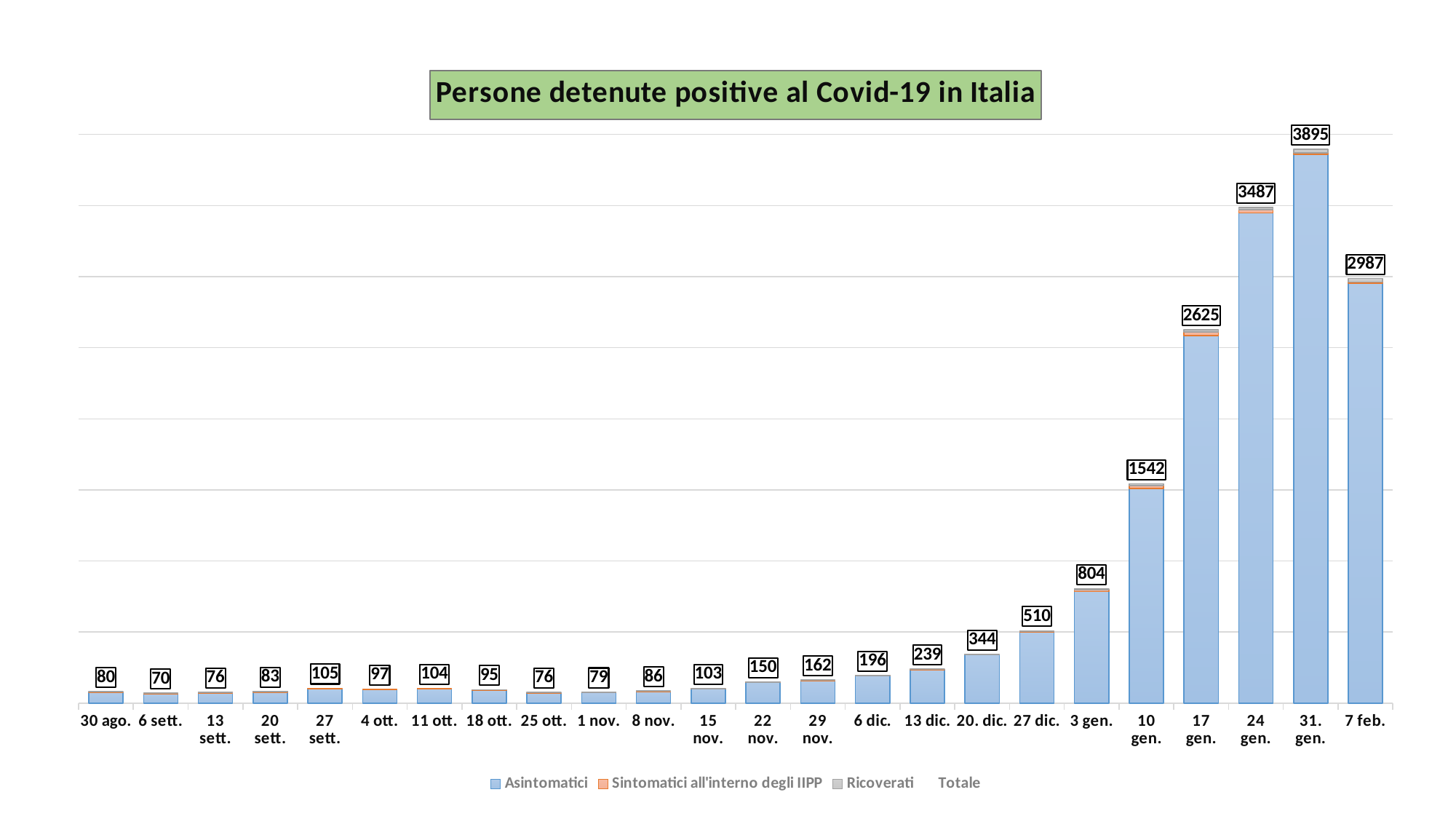
How many dates are shown on the x axis? 24 Which date has the highest total? 31. gen. Which has a larger total, 17 gen. or 7 feb.? 7 feb. What is the total value shown for 31. gen.? 3895 What is the total value shown for 30 ago.? 80 How many entries does the legend list? 4 What kind of chart is shown? Stacked bar chart Which date has the lowest total? 6 sett. What is the difference between the totals for 10 gen. and 3 gen.? 738 What is the total value shown for 7 feb.? 2987 What is the difference between the totals for 31. gen. and 24 gen.? 408 What is the title of the chart? Persone detenute positive al Covid-19 in Italia